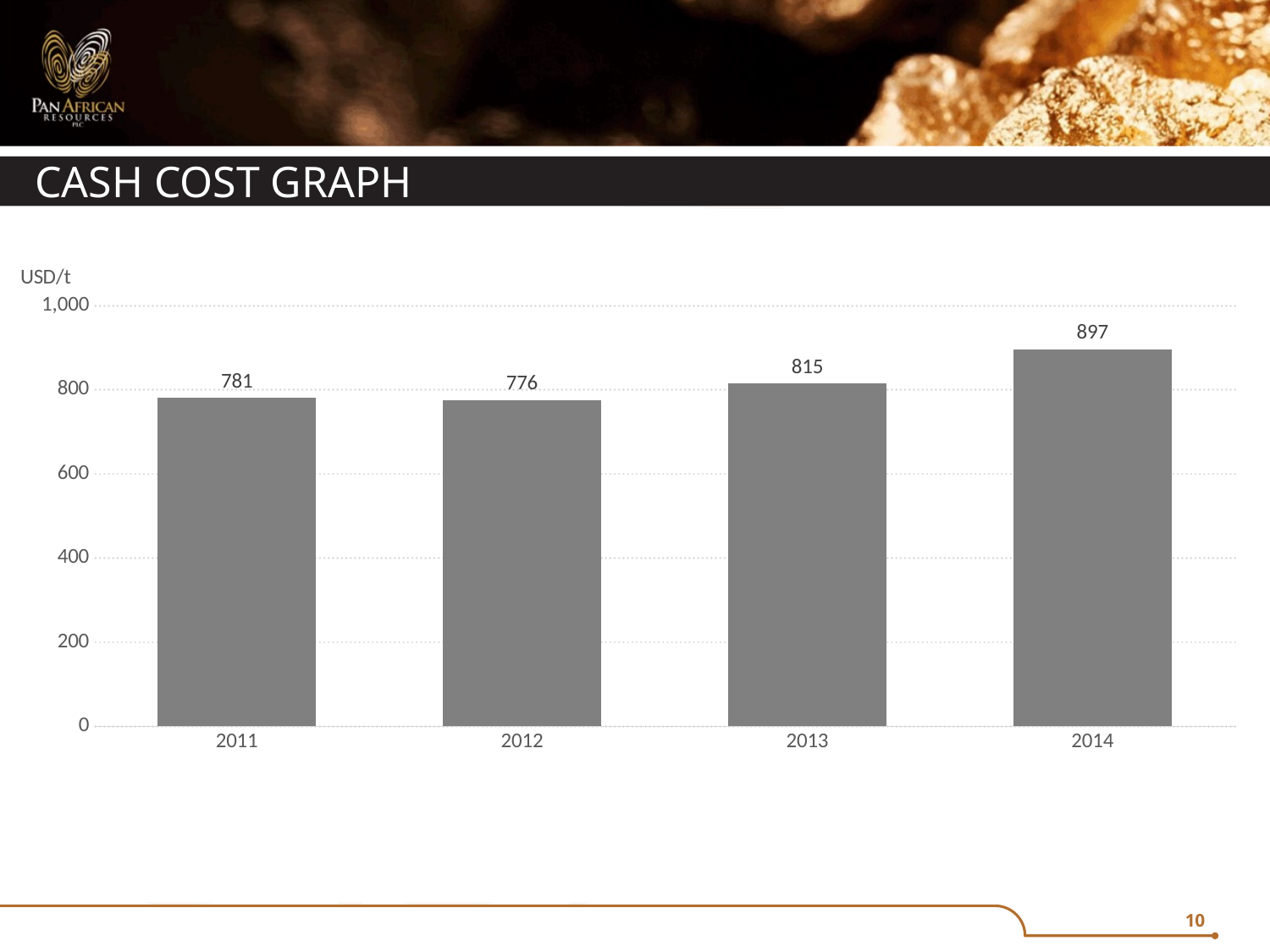
What is the difference between the cash cost in 2014 and in 2013? 82 What kind of chart is shown on the slide? Bar chart What unit is shown on the vertical axis of the chart? USD/t What is the cash cost value for 2013? 815 Which year has the lowest cash cost? 2012 Is the value for 2014 greater or less than 800? greater What is the difference between the cash cost in 2011 and in 2012? 5 What is the cash cost value for 2014? 897 Which is larger, the cash cost in 2013 or in 2011? 2013 Which year has the highest cash cost? 2014 What is the cash cost value for 2011? 781 How many years are shown on the chart? 4